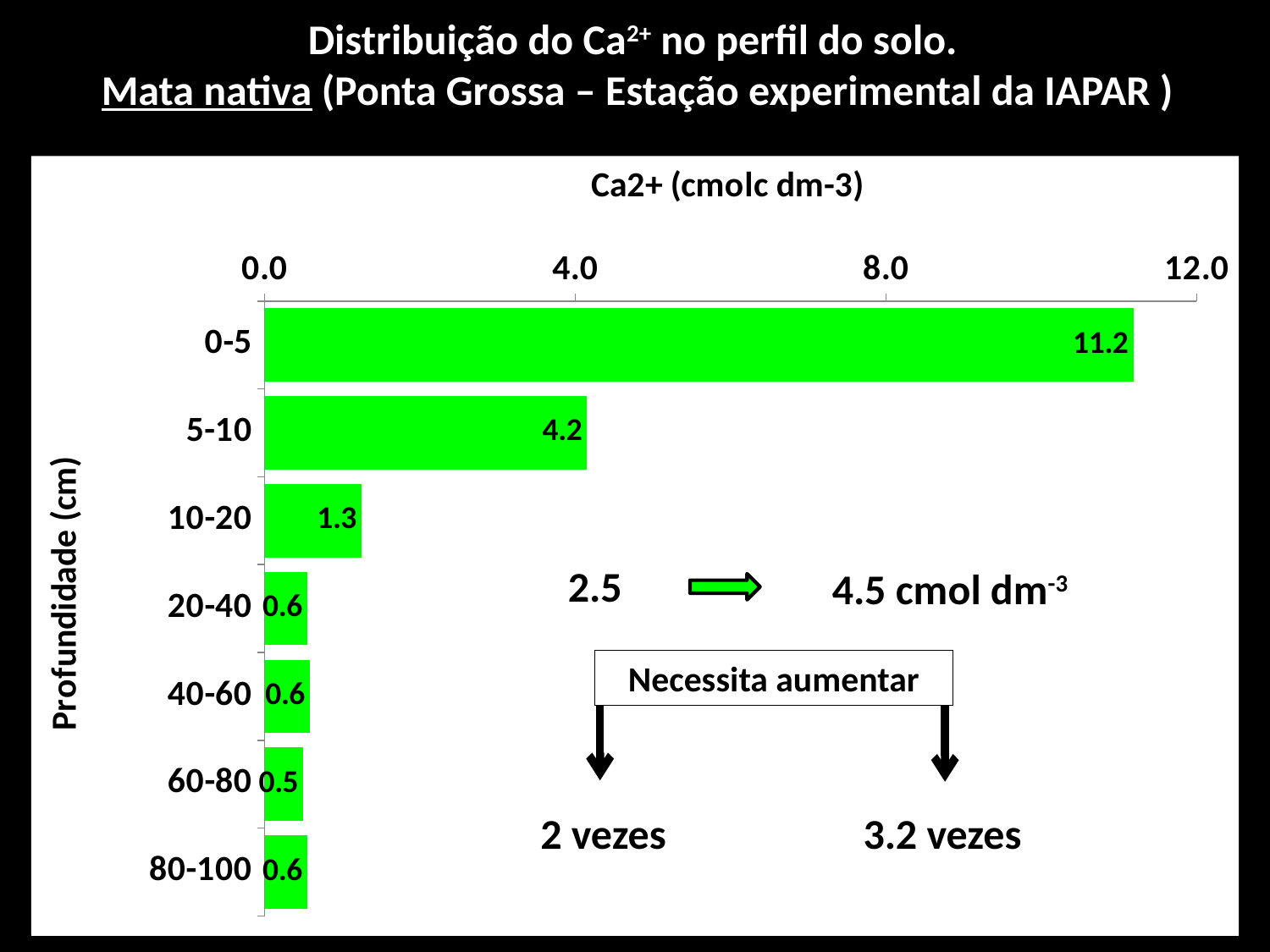
What is the Ca2+ value for the 5-10 cm depth? 4.2 What kind of chart is shown on the slide? bar chart Is the Ca2+ value for the 0-5 cm depth greater or less than 8.0? greater Which depth has the lowest Ca2+ value? 60-80 What is the difference between the Ca2+ values for the 0-5 and 5-10 cm depths? 7.0 Which depth has the highest Ca2+ value? 0-5 What is the Ca2+ value for the 60-80 cm depth? 0.5 What is the label of the vertical axis of the chart? Profundidade (cm) What is the Ca2+ value for the 10-20 cm depth? 1.3 How many depth categories are shown in the chart? 7 Which has a larger Ca2+ value, the 5-10 cm depth or the 10-20 cm depth? 5-10 What is the Ca2+ value for the 0-5 cm depth? 11.2